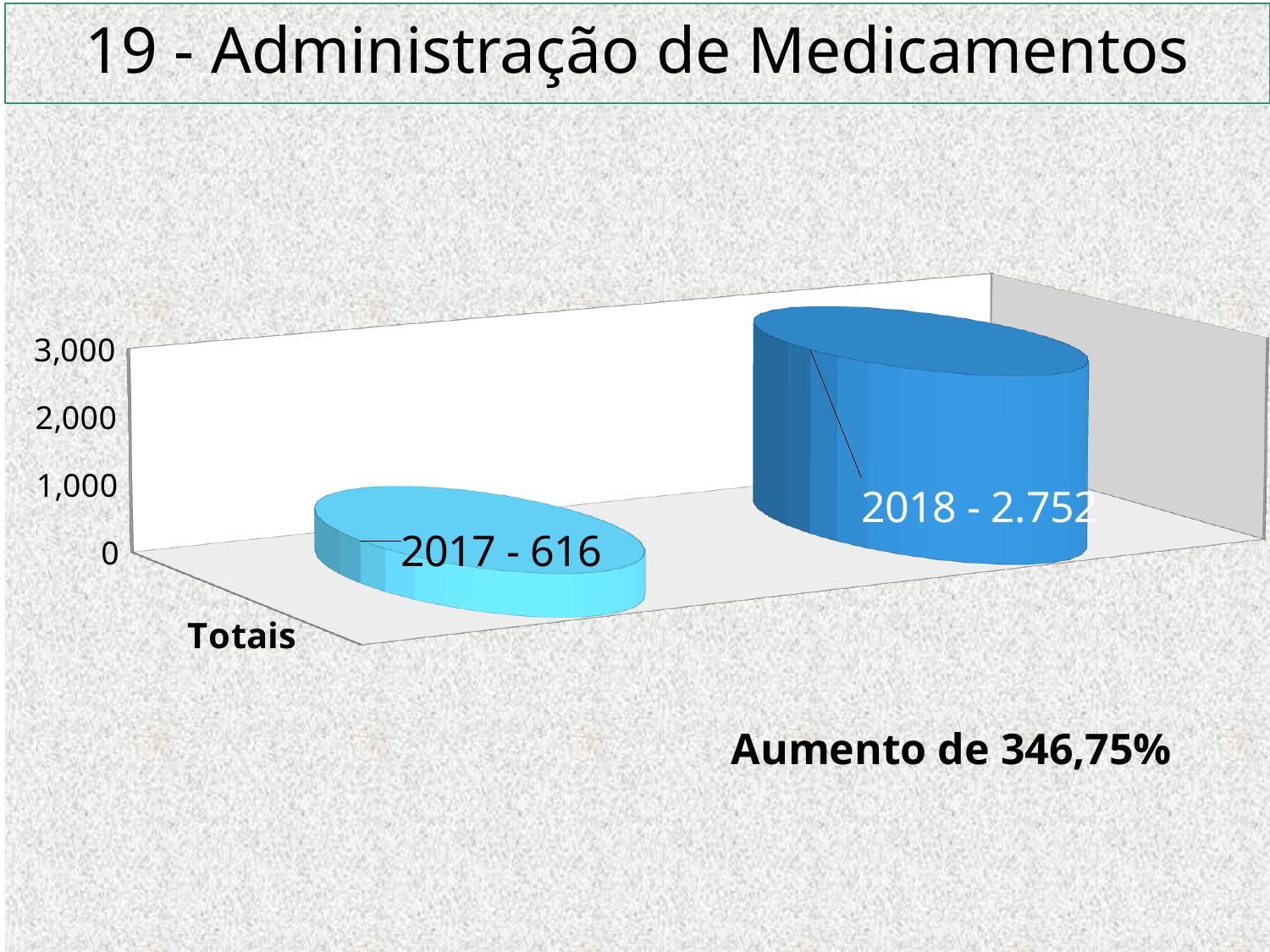
What is the title of the slide? 19 - Administração de Medicamentos What is the value shown for 2017? 616 What kind of chart is shown on the slide? bar chart What percentage increase is stated on the slide? 346,75% Do the values rise or fall from 2017 to 2018? rise Is the value for 2018 greater or less than 2,000? greater Which is larger, the value for 2017 or the value for 2018? 2018 Which year has the highest value? 2018 Is the value for 2017 greater or less than 1,000? less How many bars are plotted in the chart? 2 Which year has the lowest value? 2017 What is the value shown for 2018? 2.752